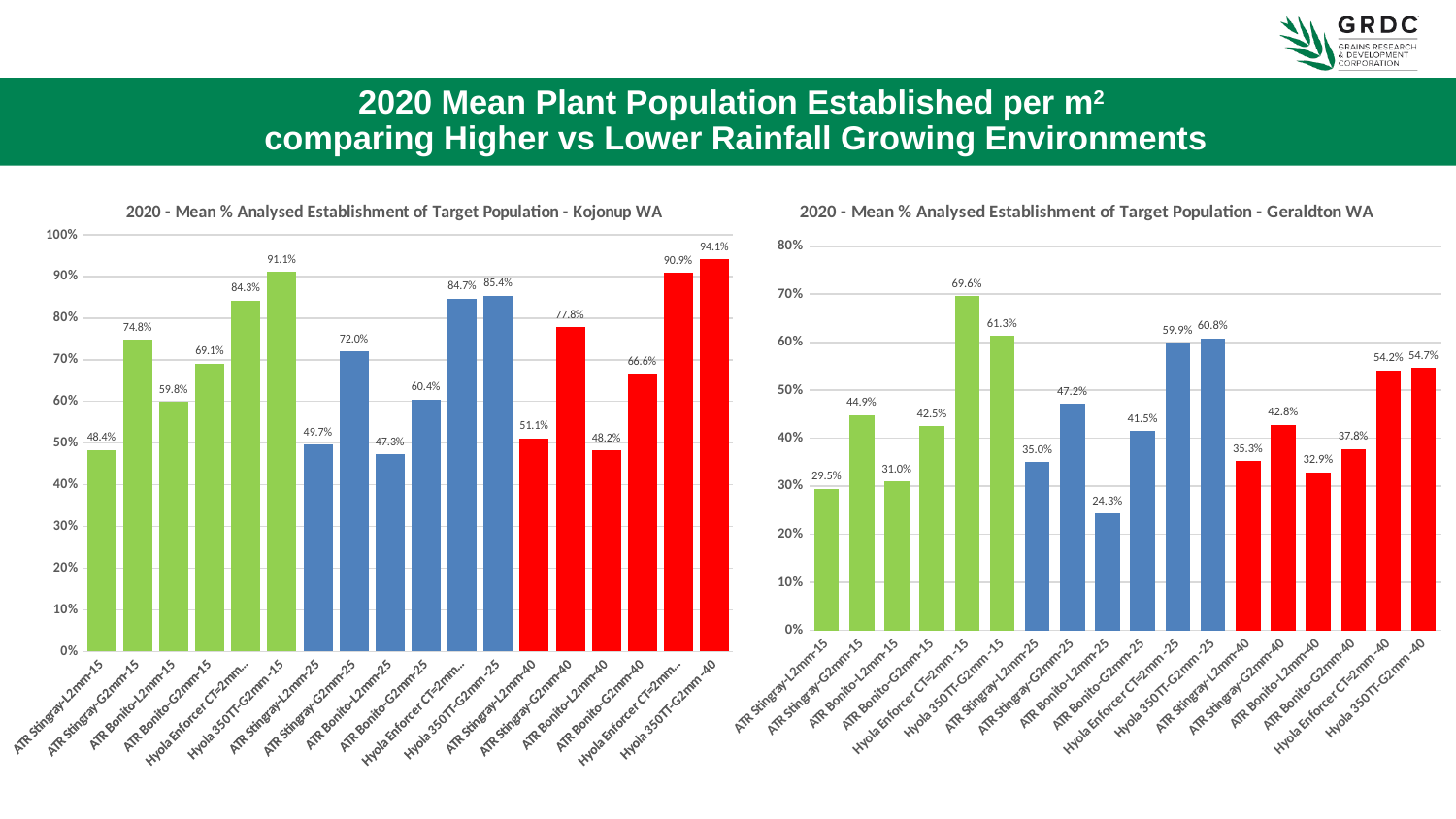
How many categories are plotted in the Kojonup WA chart? 18 In the Geraldton WA chart, what is the value for ATR Bonito-G2mm-25? 41.5% What kind of chart is the Geraldton WA chart? Bar chart In the Geraldton WA chart, which category has the highest value? Hyola Enforcer CT=2mm-15 In the Kojonup WA chart, which category has the lowest value? ATR Bonito-L2mm-25 In the Geraldton WA chart, which category has the lowest value? ATR Bonito-L2mm-25 In the Kojonup WA chart, what is the difference between ATR Stingray-G2mm-15 and ATR Stingray-L2mm-15? 26.4 percentage points What is the title of the chart on the right of the slide? 2020 - Mean % Analysed Establishment of Target Population - Geraldton WA In the Geraldton WA chart, what is the difference between Hyola Enforcer CT=2mm-15 and Hyola 350TT-G2mm-15? 8.3 percentage points In the Kojonup WA chart, which category has the highest value? Hyola 350TT-G2mm-40 In the Kojonup WA chart, what is the value for ATR Stingray-G2mm-15? 74.8% In the Geraldton WA chart, which is larger: ATR Stingray-G2mm-25 or ATR Stingray-G2mm-40? ATR Stingray-G2mm-25